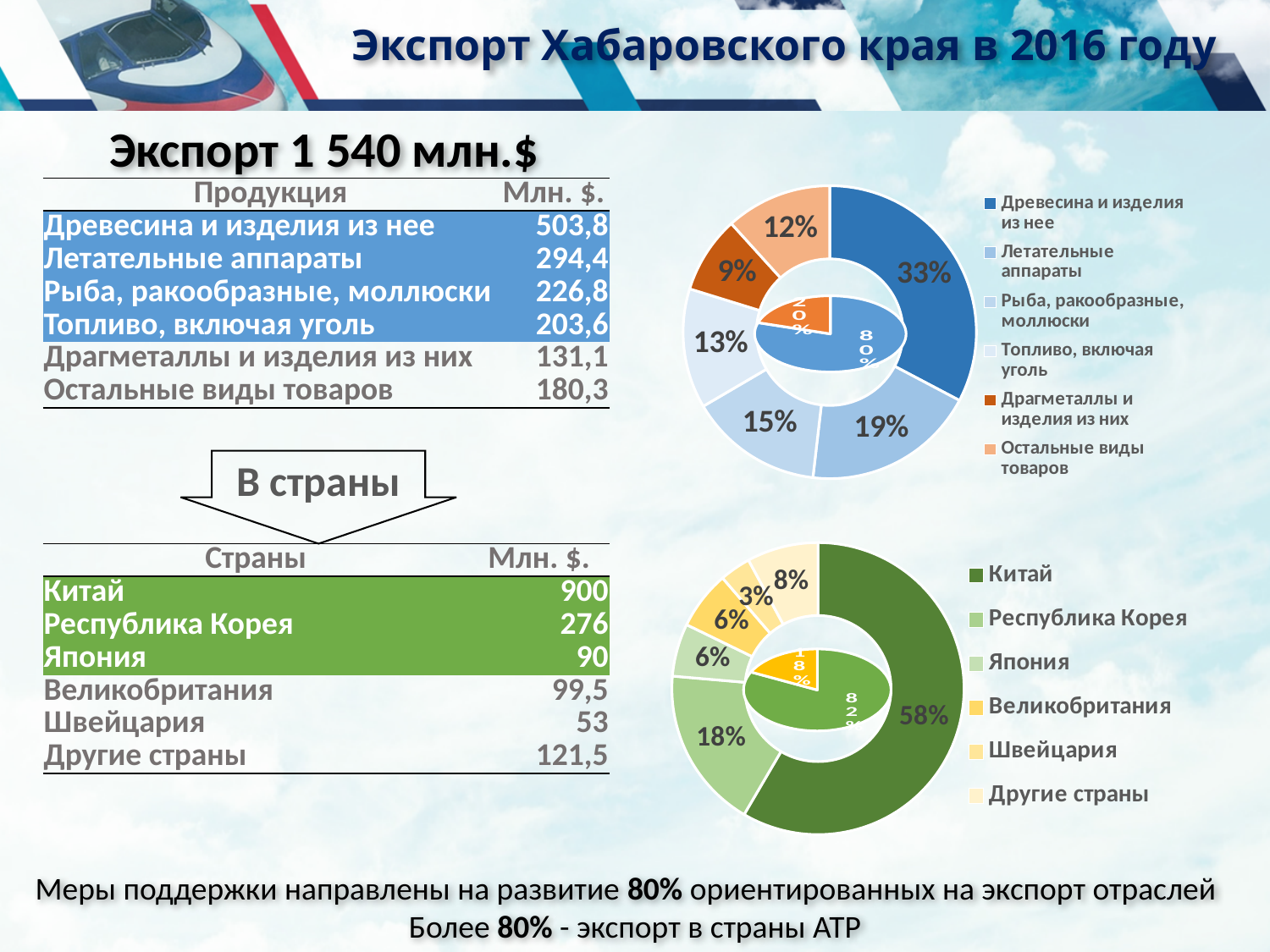
In the top chart (export by product), what share is shown for Летательные аппараты? 19% In the top chart (export by product), which category has the smallest share? Драгметаллы и изделия из них In the bottom chart (export by country), what share is shown for Швейцария? 3% In the top chart (export by product), what share is shown for Древесина и изделия из нее? 33% In the top chart (export by product), how many categories does the legend list? 6 In the bottom chart (export by country), which country has the smallest share? Швейцария In the top chart (export by product), what share is shown for Драгметаллы и изделия из них? 9% In the bottom chart (export by country), what share is shown for Республика Корея? 18% What type of chart is used for the export by country on the bottom of the slide? Doughnut (pie) chart In the bottom chart (export by country), what is the difference in percentage points between Китай and Республика Корея? 40 In the top chart (export by product), which category has the largest share? Древесина и изделия из нее In the bottom chart (export by country), what share is shown for Китай? 58%